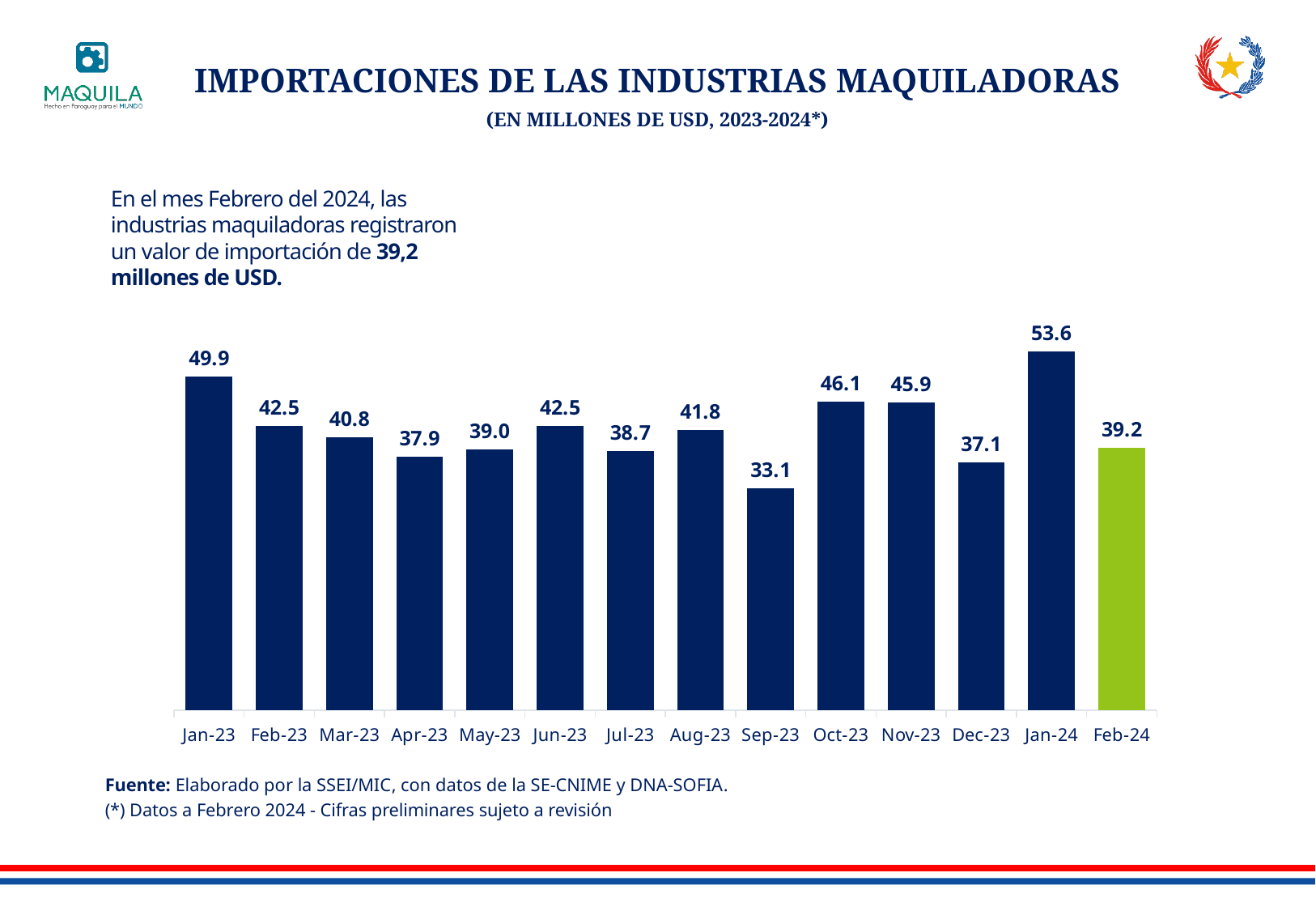
What is the import value for Sep-23? 33.1 Which is larger, the import value for Nov-23 or Dec-23? Nov-23 What is the difference between the import values for Jan-24 and Feb-24? 14.4 What kind of chart is shown on the slide? Bar chart What is the import value for Oct-23? 46.1 Do the import values rise or fall from Oct-23 to Dec-23? Fall What is the difference between the import values for Jan-23 and Feb-23? 7.4 Which month has the highest import value? Jan-24 Which bar is shown in a different colour (green) from the others? Feb-24 How many months are shown on the chart? 14 Which month has the lowest import value? Sep-23 What is the import value for Feb-24? 39.2